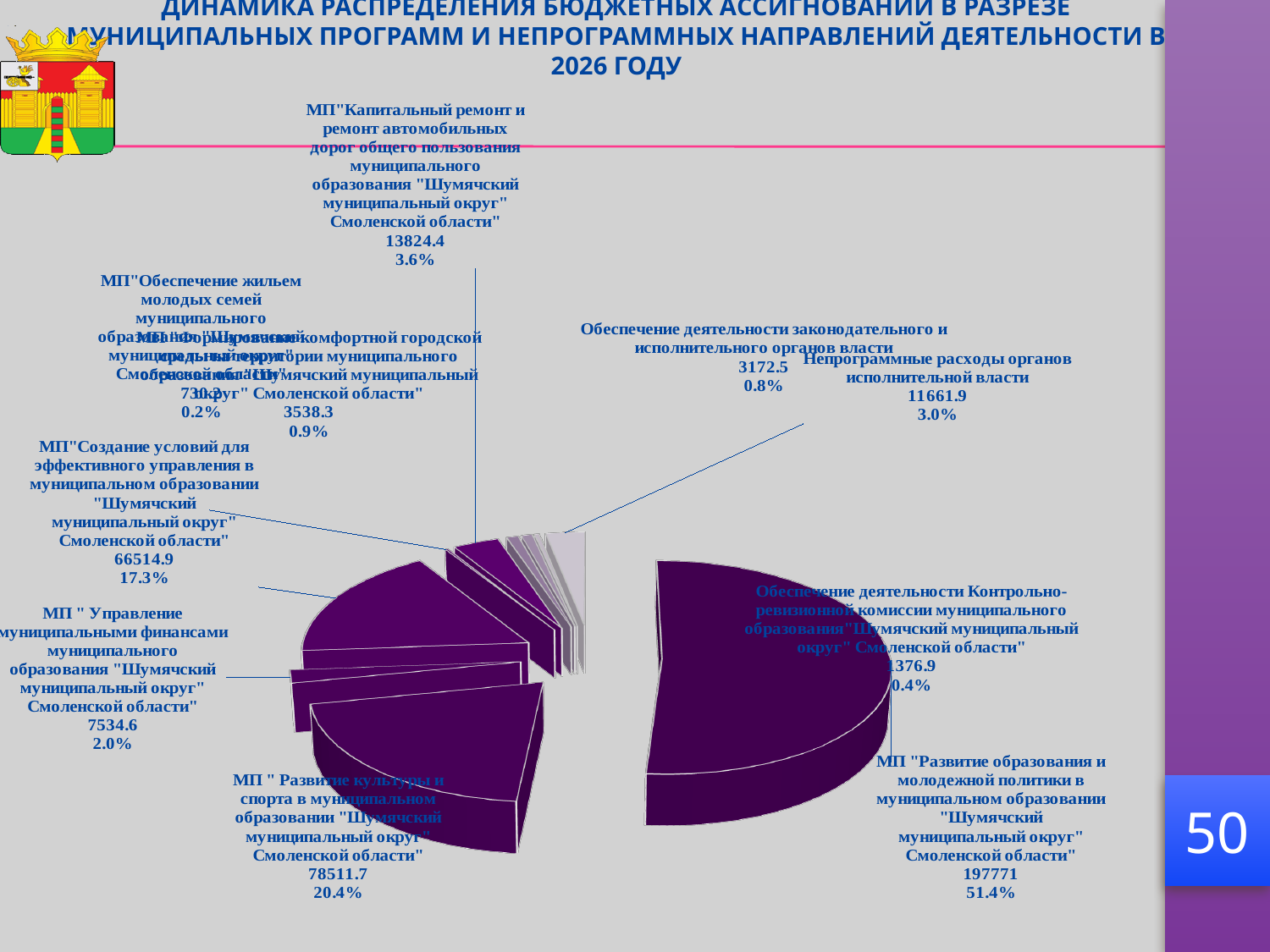
Which year does the chart title say the budget allocation distribution refers to? 2026 What share of the pie does МП "Развитие образования и молодежной политики" have? 51.4% What share of the pie does МП "Создание условий для эффективного управления" have? 17.3% How many categories (slices) does the pie chart show? 10 What is the difference between the values for МП "Развитие культуры и спорта" (78511.7) and МП "Создание условий для эффективного управления" (66514.9)? 11996.8 What share of the pie does Обеспечение деятельности Контрольно-ревизионной комиссии have? 0.4% What is the value shown for МП "Развитие образования и молодежной политики"? 197771 Which is larger: the value for МП "Капитальный ремонт и ремонт автомобильных дорог" or for Непрограммные расходы органов исполнительной власти? МП "Капитальный ремонт и ремонт автомобильных дорог" What is the value shown for МП "Развитие культуры и спорта"? 78511.7 What kind of chart is shown on the slide? Pie chart Which category has the largest share of the pie? МП "Развитие образования и молодежной политики в муниципальном образовании "Шумячский муниципальный округ" Смоленской области" What is the value shown for Непрограммные расходы органов исполнительной власти? 11661.9